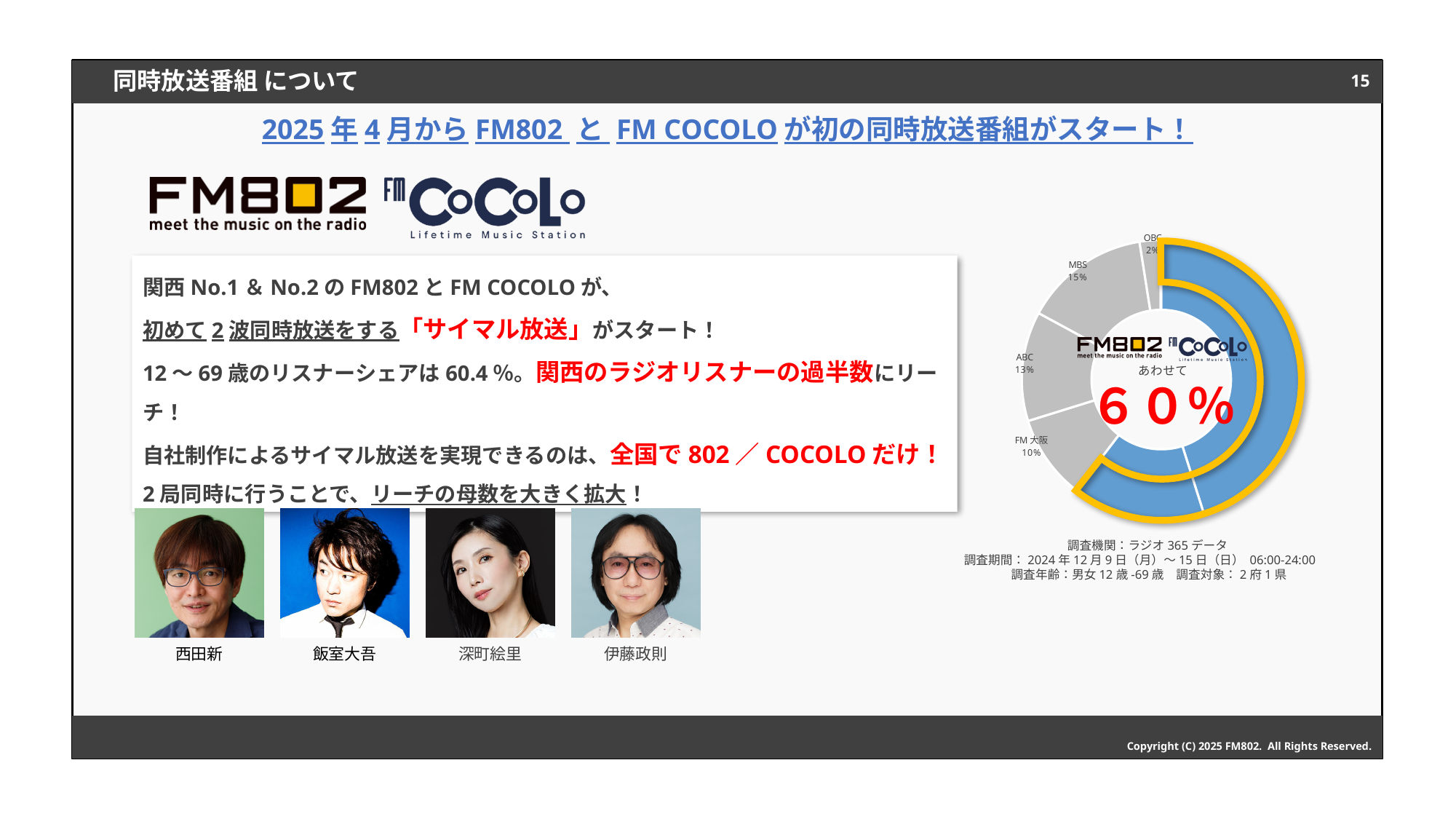
Among the grey-labelled stations in the donut chart (OBC, MBS, ABC, FM大阪), which has the smallest share? OBC In the donut chart, which has the larger share, ABC or FM大阪? ABC In the donut chart, what is the total share of OBC, MBS, ABC and FM大阪 combined? 40% What kind of chart is shown on the right side of the slide? Pie chart (donut) In the donut chart, what listener share is shown for OBC? 2% In the donut chart, what listener share is shown for ABC? 13% In the donut chart, what listener share is shown for MBS? 15% Among the grey-labelled stations in the donut chart (OBC, MBS, ABC, FM大阪), which has the largest share? MBS In the donut chart, what colour are the segments representing FM802 and FM COCOLO? Blue In the donut chart, what listener share is shown for FM大阪? 10% In the donut chart, how many percentage points larger is MBS's share than ABC's share? 2 percentage points According to the centre of the donut chart, what is the combined share of FM802 and FM COCOLO? 60%